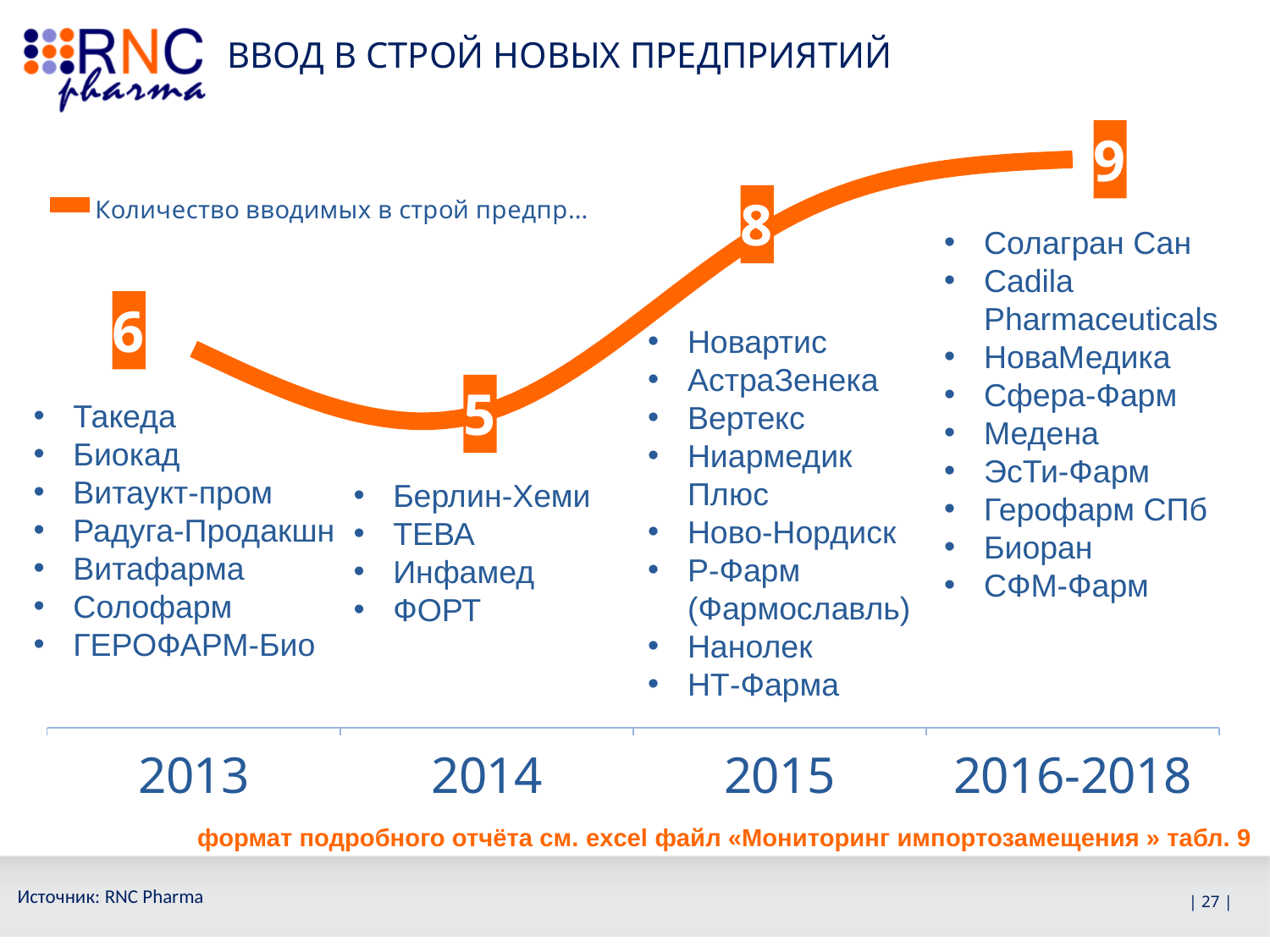
What is the value for 2016-2018? 9 Which is larger, the value for 2013 or the value for 2014? 2013 How many periods are shown on the x axis? 4 What is the value for 2014? 5 What is the value for 2015? 8 What is the title of the slide? ВВОД В СТРОЙ НОВЫХ ПРЕДПРИЯТИЙ What is the difference between the values for 2015 and 2014? 3 Does the value rise or fall from 2014 to 2016-2018? rise What kind of chart is shown on the slide? line chart Which period has the highest value? 2016-2018 What is the value for 2013? 6 Which period has the lowest value? 2014